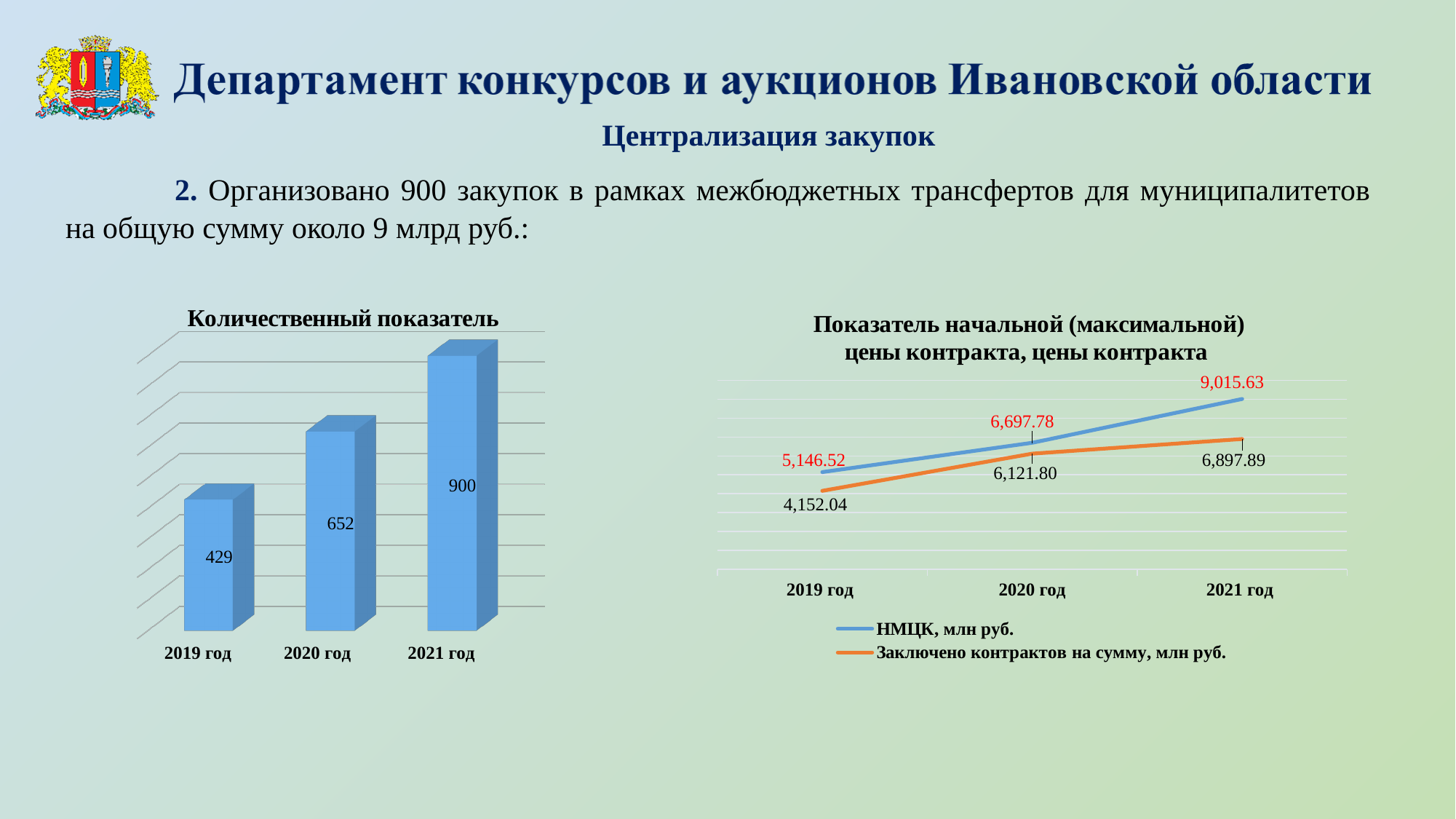
What kind of chart is the chart titled "Количественный показатель"? Bar chart In the chart on the right ("Показатель начальной (максимальной) цены контракта, цены контракта"), what colour is the line for "Заключено контрактов на сумму, млн руб."? Orange In the chart on the right ("Показатель начальной (максимальной) цены контракта, цены контракта"), which series has the larger value for 2020 год: "НМЦК, млн руб." or "Заключено контрактов на сумму, млн руб."? НМЦК, млн руб. In the chart titled "Количественный показатель", what is the value for 2021 год? 900 In the chart titled "Количественный показатель", how many bars are plotted? 3 In the chart on the right ("Показатель начальной (максимальной) цены контракта, цены контракта"), how many series does the legend list? 2 In the chart titled "Количественный показатель", what is the difference between the values for 2021 год and 2020 год? 248 In the chart titled "Количественный показатель", what is the value for 2019 год? 429 In the chart on the right ("Показатель начальной (максимальной) цены контракта, цены контракта"), do the values of "НМЦК, млн руб." rise or fall from 2019 год to 2021 год? Rise In the chart on the right ("Показатель начальной (максимальной) цены контракта, цены контракта"), what is the value of "НМЦК, млн руб." for 2021 год? 9,015.63 In the chart on the right ("Показатель начальной (максимальной) цены контракта, цены контракта"), what is the value of "Заключено контрактов на сумму, млн руб." for 2019 год? 4,152.04 In the chart titled "Количественный показатель", which year has the lowest value? 2019 год